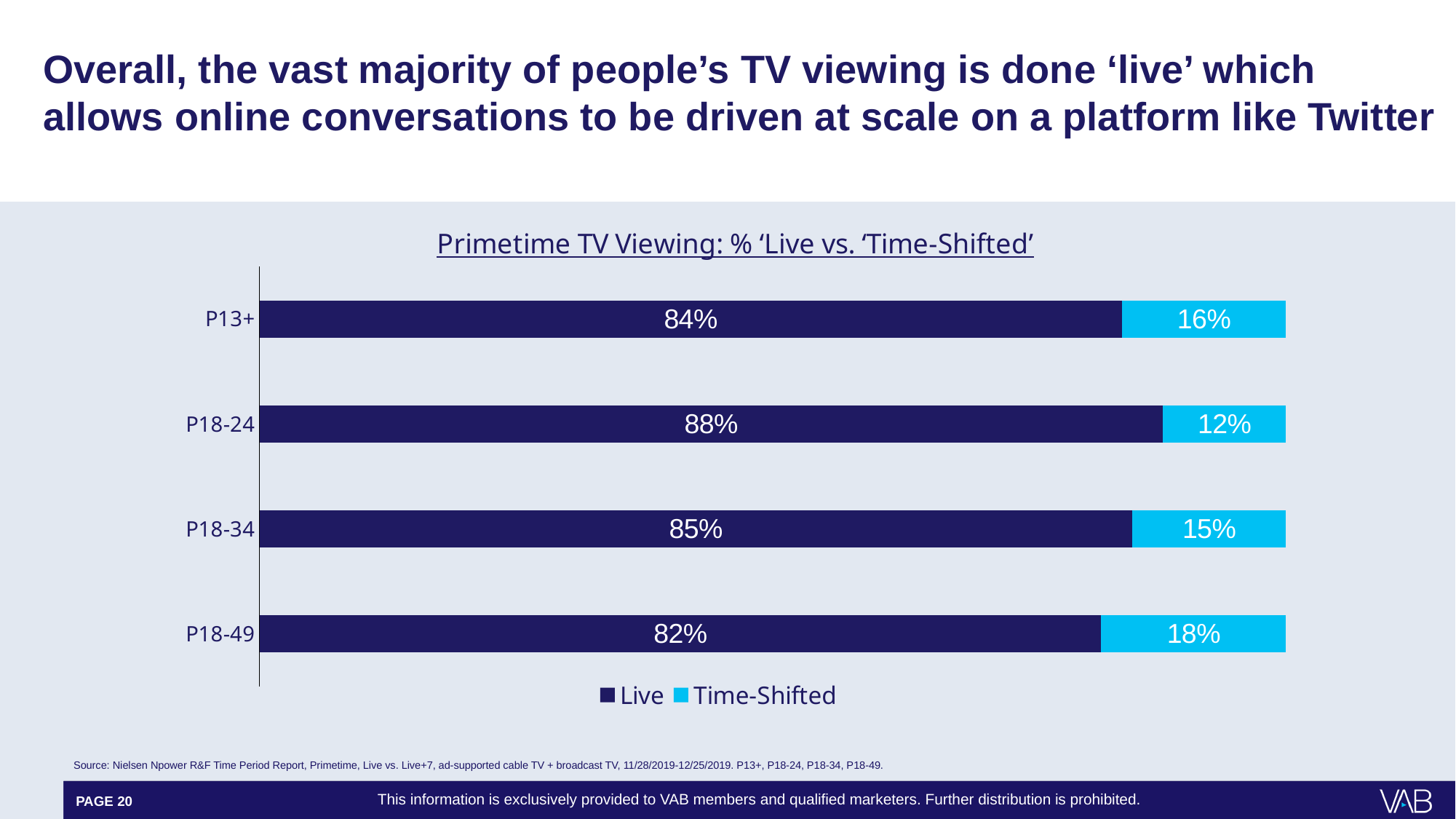
What is the Live share of primetime TV viewing for P18-24? 88% What is the title of the chart? Primetime TV Viewing: % 'Live vs. 'Time-Shifted' Which demographic has the highest Live share of primetime TV viewing? P18-24 Which is larger: the Time-Shifted share for P13+ or for P18-34? P13+ Which demographic has the lowest Time-Shifted share of primetime TV viewing? P18-24 What is the total of the Live and Time-Shifted segments for P18-34? 100% What type of chart is shown on the slide? Stacked bar chart What is the Time-Shifted share of primetime TV viewing for P18-49? 18% How many demographic groups are shown in the chart? 4 What is the difference between the Live share for P18-24 and the Live share for P18-49? 6 percentage points What is the Live share of primetime TV viewing for P13+? 84% How many series does the legend list? 2